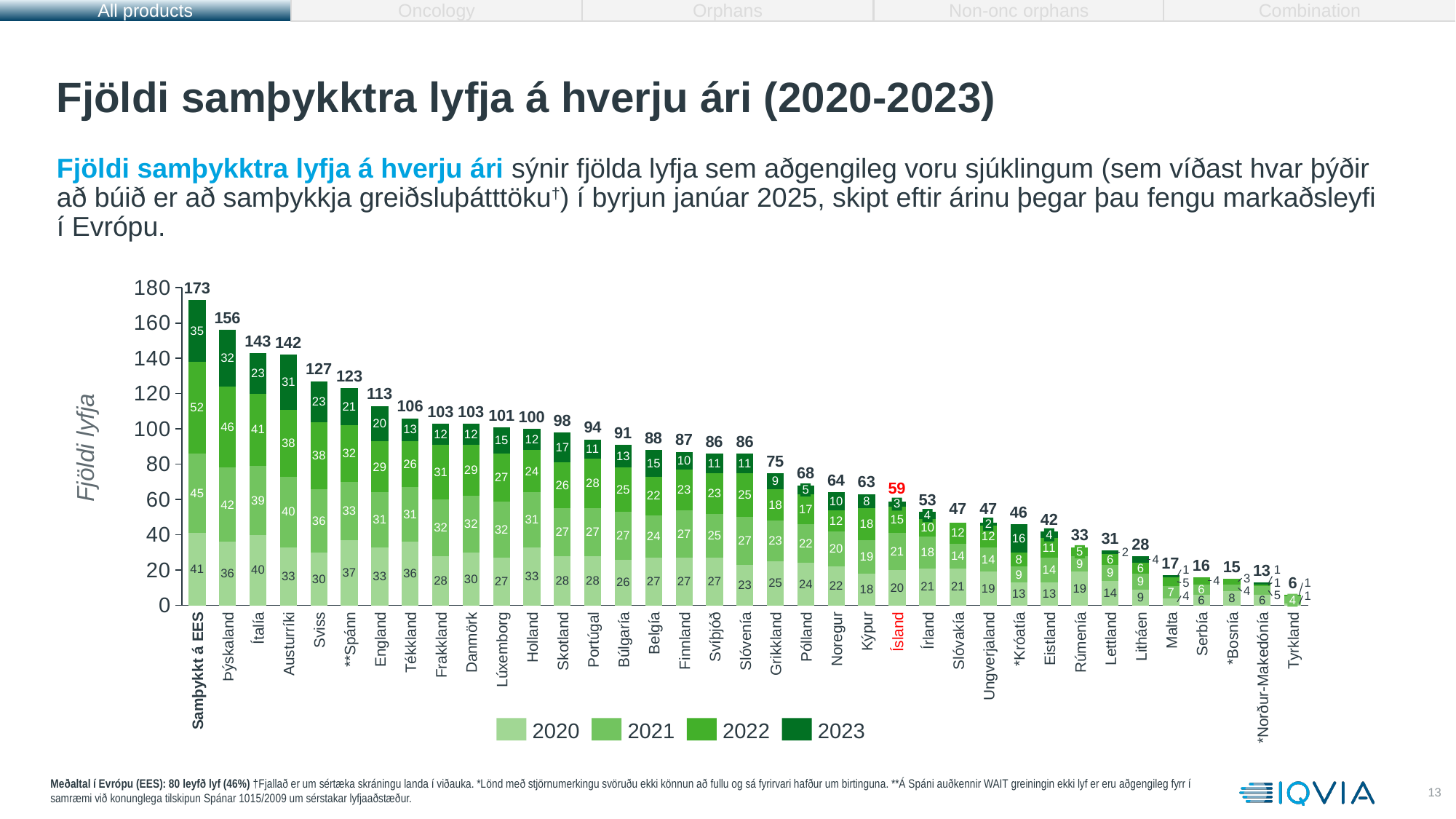
Which has a larger total, Sviss or **Spánn? Sviss Do the bar totals rise or fall moving from left to right along the x axis? Fall What is the total number of approved drugs shown for Ísland? 59 What kind of chart is shown on the slide? Stacked bar chart What is the difference between the totals for Þýskaland and Ítalía? 13 Is the total for Grikkland greater or less than 80? less What is the 2020 value for Þýskaland? 36 Which country has the lowest total? Tyrkland Which category has the highest total? Samþykkt á EES How many series does the legend list? 4 What is the label on the y axis? Fjöldi lyfja What is the 2023 value for Samþykkt á EES? 35